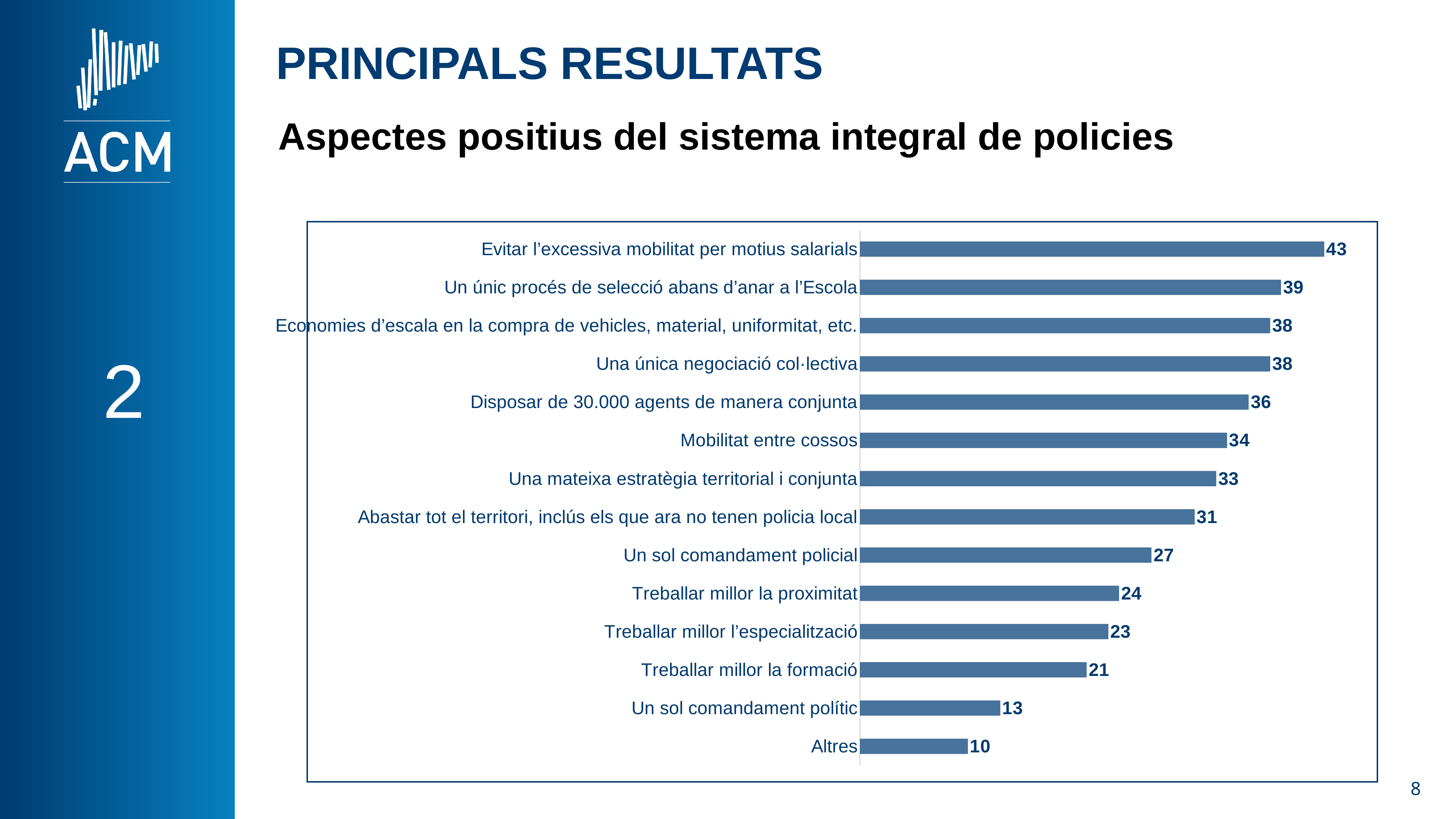
What kind of chart is shown on the slide? Bar chart What is the value for "Evitar l'excessiva mobilitat per motius salarials"? 43 What is the subtitle above the chart? Aspectes positius del sistema integral de policies What is the value for "Un sol comandament polític"? 13 Which is larger: the value for "Treballar millor la proximitat" or the value for "Abastar tot el territori, inclús els que ara no tenen policia local"? Abastar tot el territori, inclús els que ara no tenen policia local How many categories are shown in the chart? 14 What is the value for "Mobilitat entre cossos"? 34 What is the value for "Treballar millor la formació"? 21 What is the difference between the values for "Un únic procés de selecció abans d'anar a l'Escola" and "Un sol comandament policial"? 12 Which category has the lowest value? Altres Which category has the highest value? Evitar l'excessiva mobilitat per motius salarials What is the difference between the values for "Disposar de 30.000 agents de manera conjunta" and "Altres"? 26